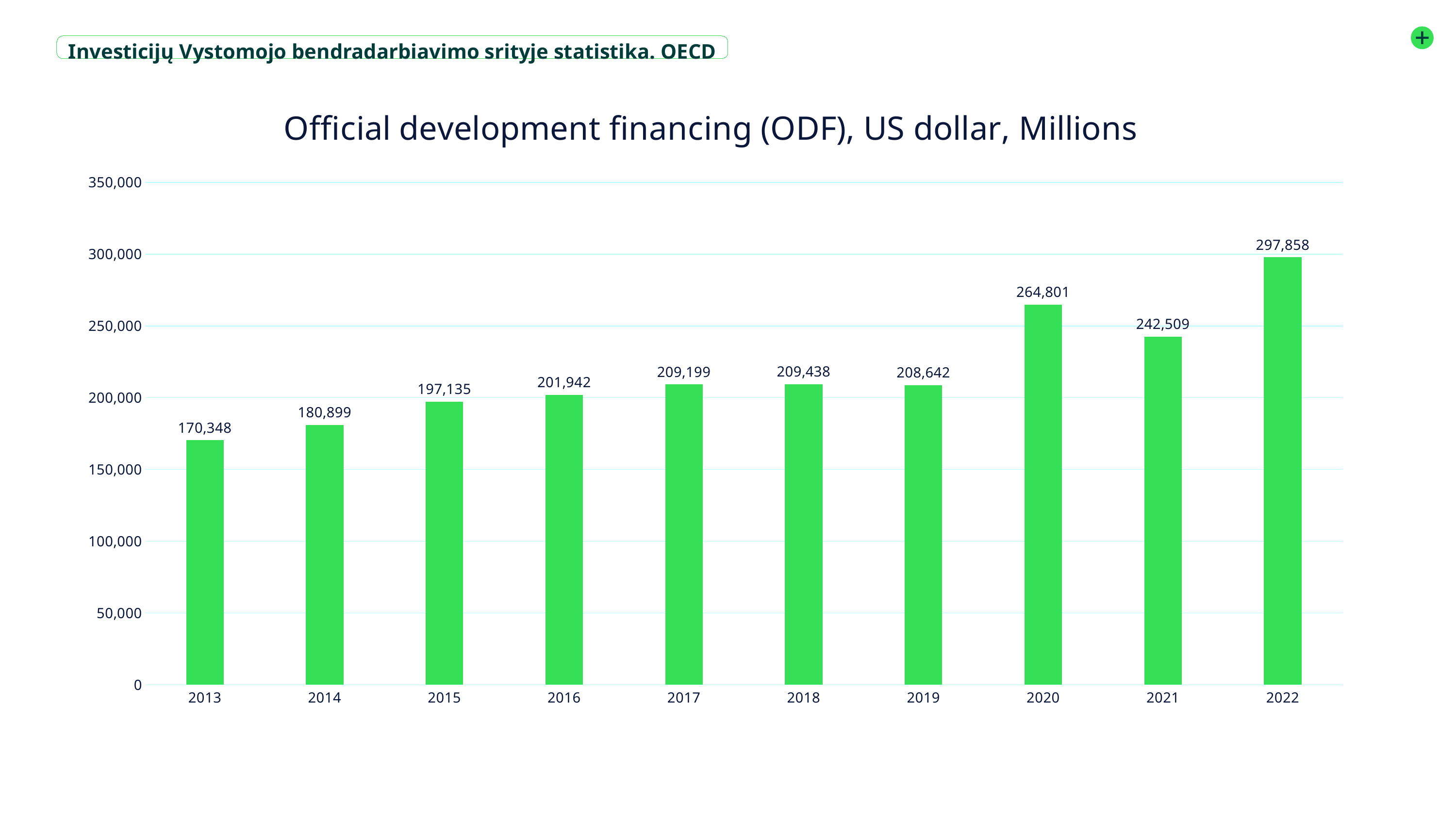
Which is larger, the value for 2020 or the value for 2021? 2020 Is the value for 2015 greater or less than 200,000? less What is the value for 2016? 201,942 What kind of chart is shown? bar chart Which year has the highest value? 2022 What is the value for 2013? 170,348 What is the value for 2020? 264,801 Which year has the lowest value? 2013 What is the difference between the values for 2022 and 2021? 55,349 What is the difference between the values for 2014 and 2013? 10,551 How many years are shown on the x axis? 10 What is the title of the chart? Official development financing (ODF), US dollar, Millions